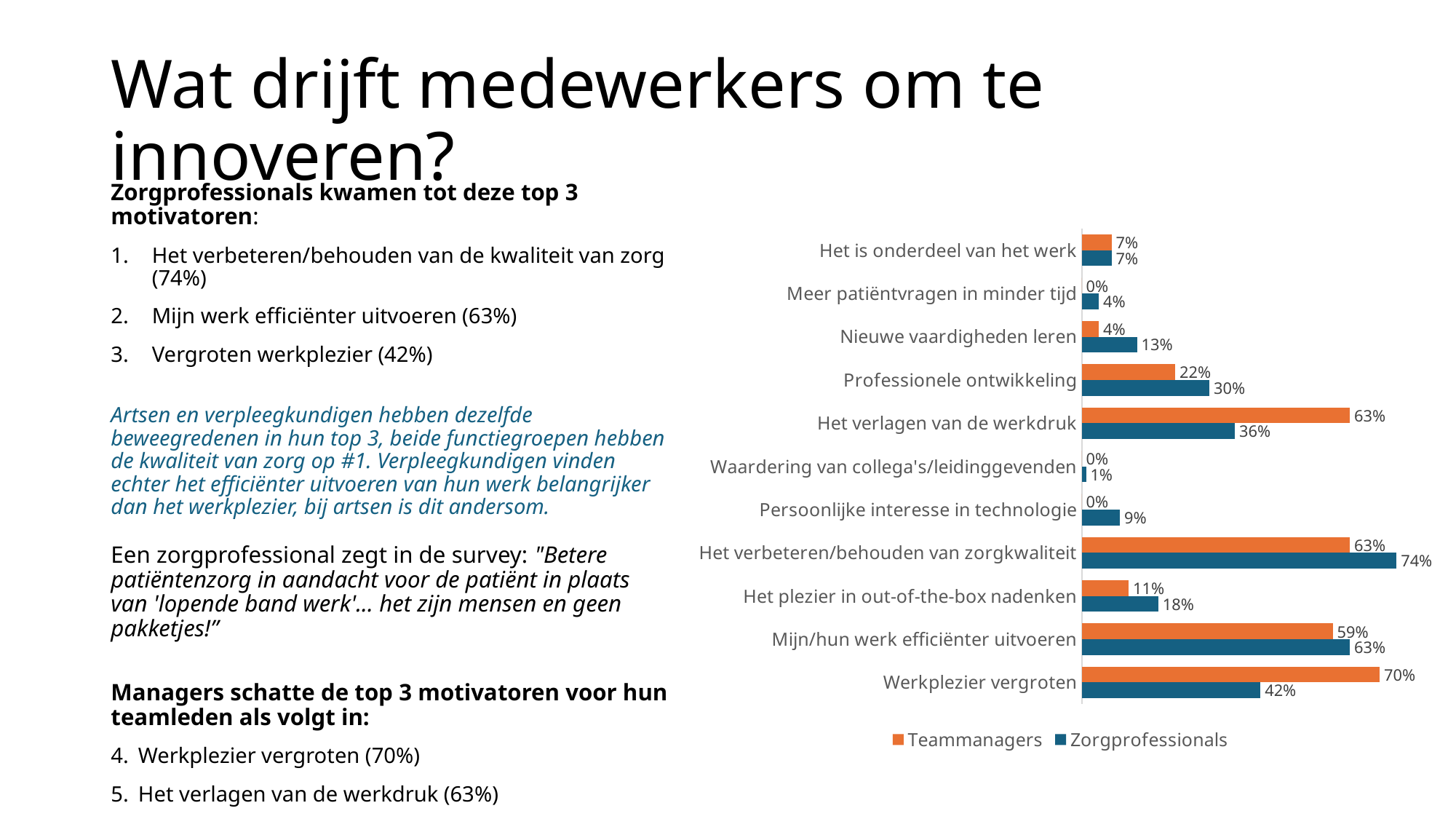
What is the difference between the Teammanagers and Zorgprofessionals values for 'Het verlagen van de werkdruk'? 27% What is the Zorgprofessionals value for 'Het verbeteren/behouden van zorgkwaliteit'? 74% Which category has the lowest Zorgprofessionals value? Waardering van collega's/leidinggevenden For 'Werkplezier vergroten', which series has the larger value, Teammanagers or Zorgprofessionals? Teammanagers What type of chart is shown on the slide? bar chart How many categories are shown in the chart? 11 Which series is shown in orange in the chart? Teammanagers What is the Teammanagers value for 'Werkplezier vergroten'? 70% What is the Zorgprofessionals value for 'Nieuwe vaardigheden leren'? 13% Which category has the highest Zorgprofessionals value? Het verbeteren/behouden van zorgkwaliteit How many series does the chart legend list? 2 Which category has the highest Teammanagers value? Werkplezier vergroten